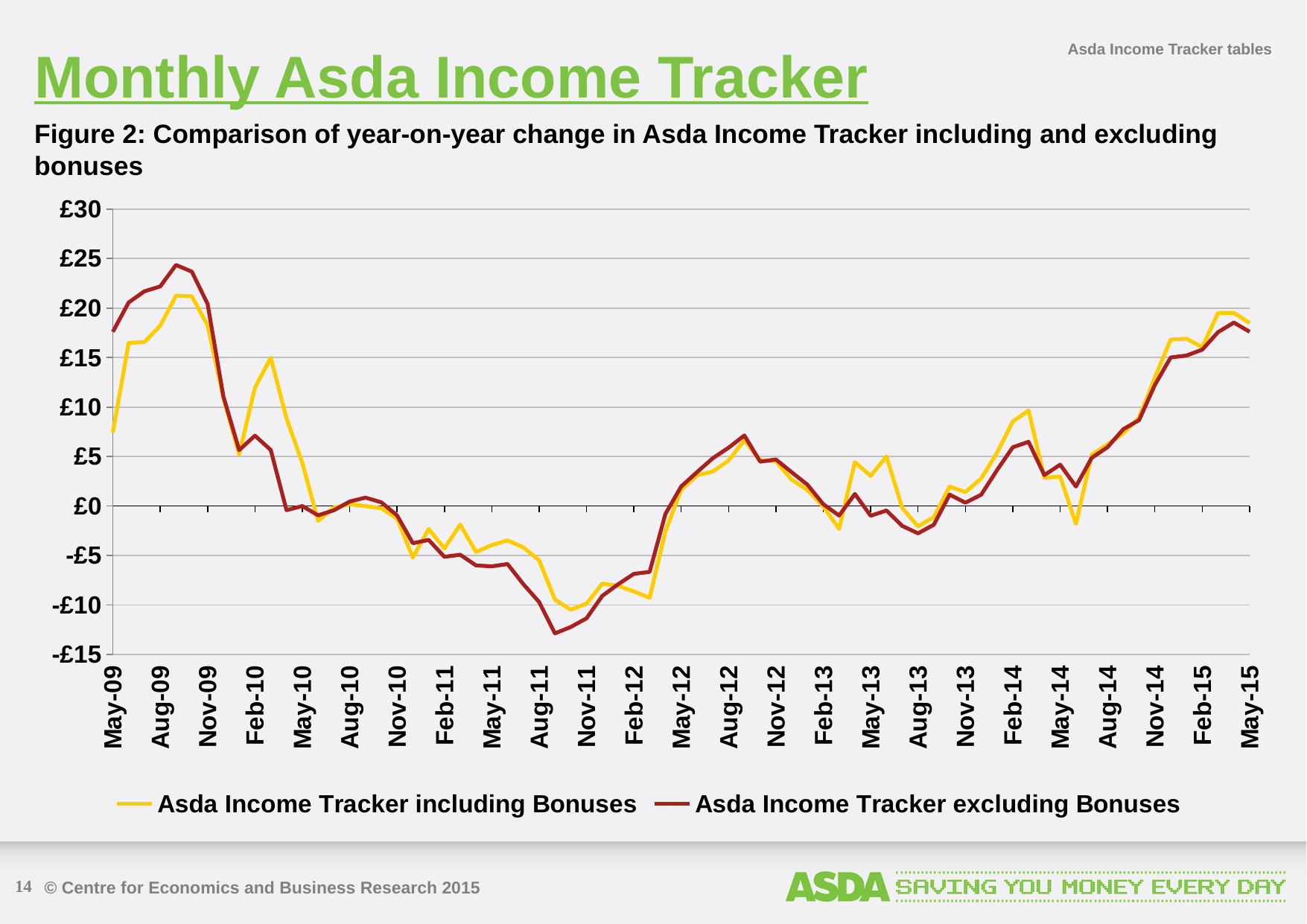
At Feb-10, which series has the higher value, including Bonuses or excluding Bonuses? Asda Income Tracker including Bonuses Which series is drawn in yellow? Asda Income Tracker including Bonuses What kind of chart is shown on the slide? line chart Is the value for Asda Income Tracker including Bonuses at Feb-10 greater or less than £10? greater At May-09, which series has the higher value, including Bonuses or excluding Bonuses? Asda Income Tracker excluding Bonuses Is the value for Asda Income Tracker including Bonuses at May-15 greater or less than £15? greater How many series does the legend list? 2 Does the Asda Income Tracker including Bonuses line rise or fall between Aug-13 and Feb-15? rise Which series reaches the highest peak on the chart? Asda Income Tracker excluding Bonuses Is the value for Asda Income Tracker excluding Bonuses at Aug-09 greater or less than £20? greater What is the figure number and title of the chart? Figure 2: Comparison of year-on-year change in Asda Income Tracker including and excluding bonuses